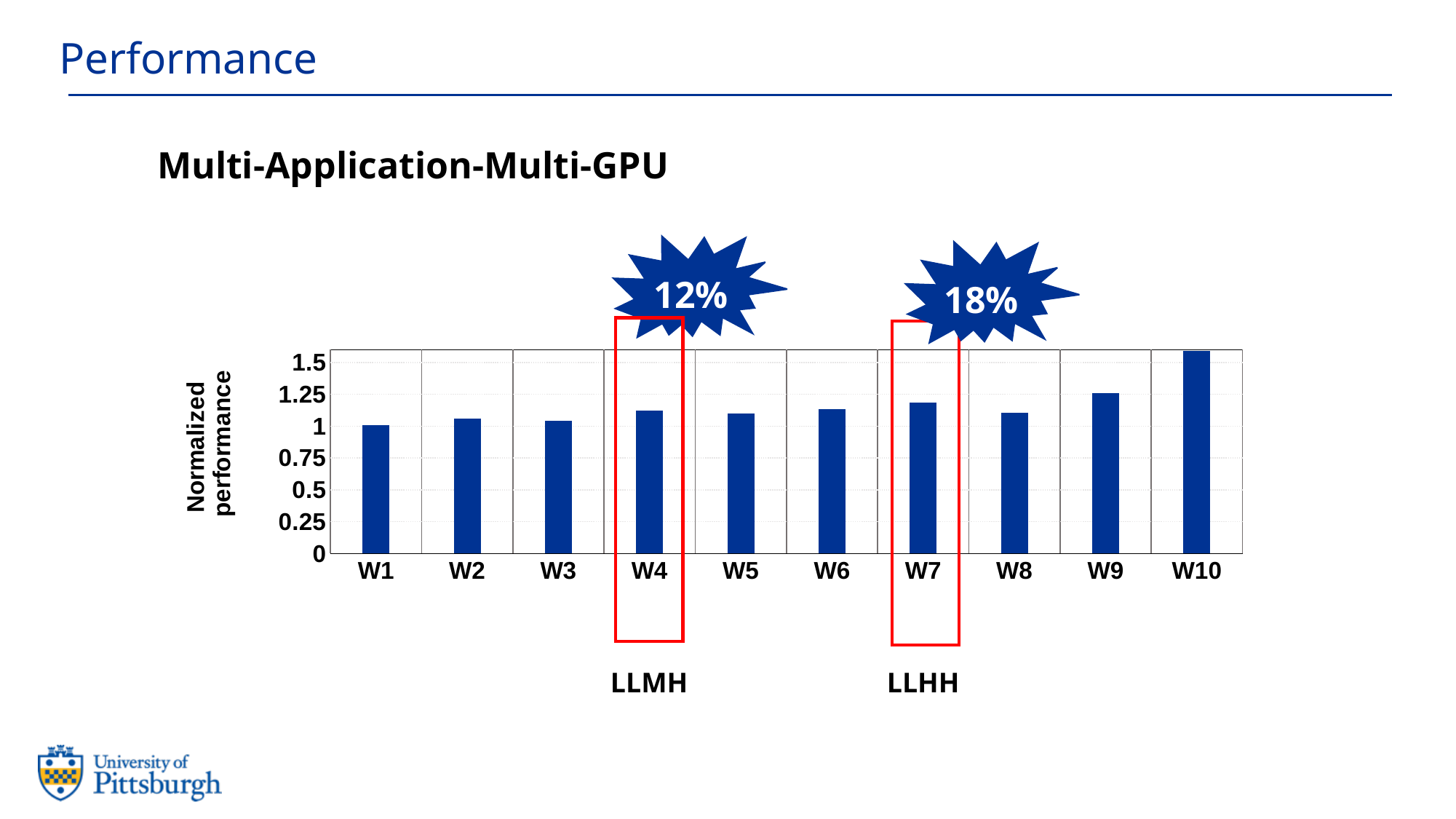
Is the normalized performance for W9 greater or less than 1? greater Is the normalized performance for W3 greater or less than 1.25? less Is the normalized performance for W10 greater or less than 1.5? greater Which has a higher normalized performance, W1 or W10? W10 Which workload has the highest normalized performance? W10 Which workload has the lowest normalized performance? W1 What label is shown below the red box around W7? LLHH What kind of chart is shown on the slide? bar chart What percentage improvement is called out above the W4 bar? 12% How many workloads (categories) are plotted on the x axis? 10 Which has a higher normalized performance, W9 or W2? W9